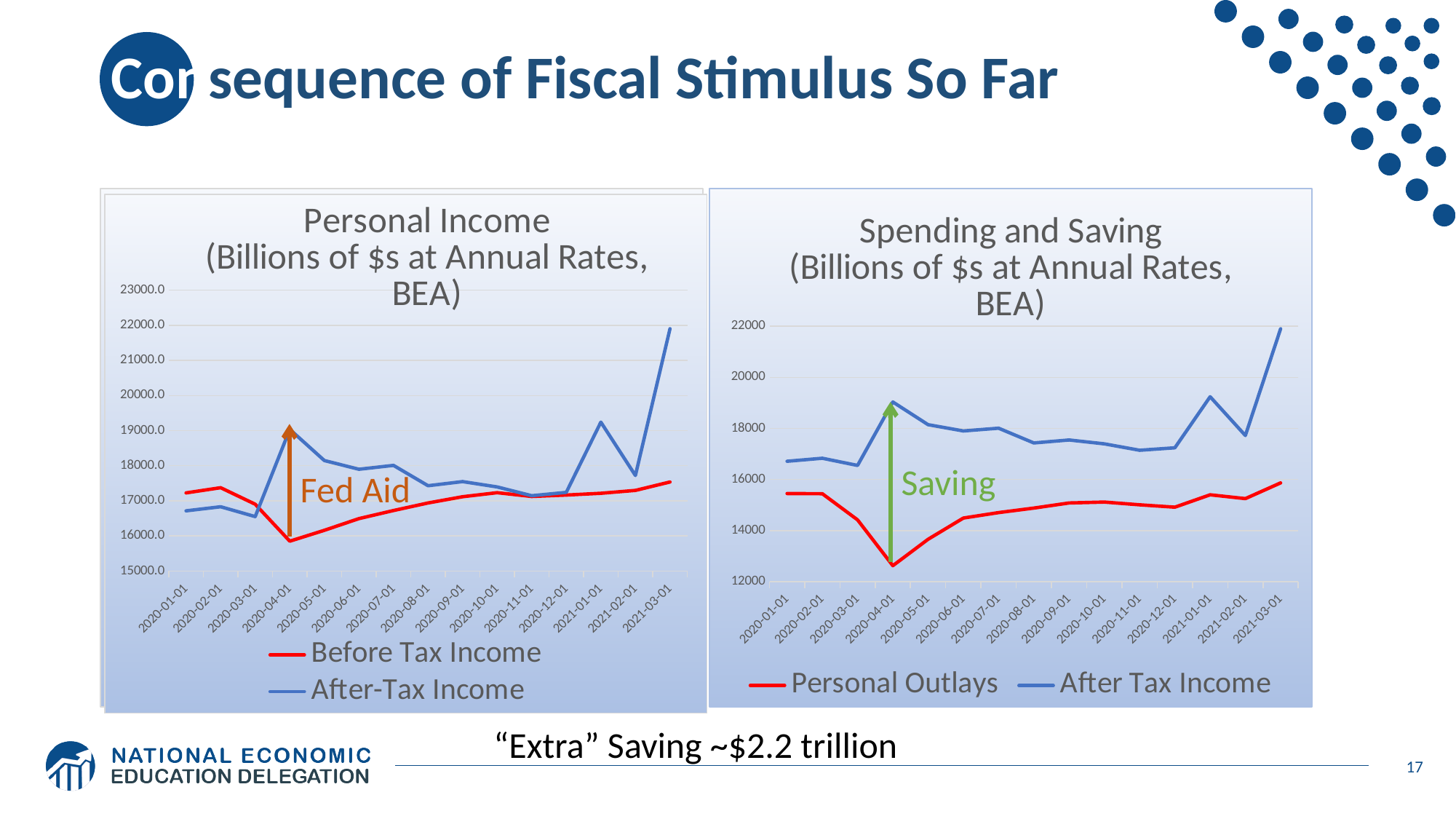
In the 'Personal Income' chart on the left, is the After-Tax Income value for 2020-01-01 greater or less than 17000.0? less In the 'Personal Income' chart on the left, is the After-Tax Income value for 2021-03-01 greater or less than 21000.0? greater What kind of chart is the 'Personal Income' chart on the left? line chart In the 'Personal Income' chart on the left, at which date is Before Tax Income lowest? 2020-04-01 In the 'Personal Income' chart on the left, which series has the larger value at 2020-04-01, Before Tax Income or After-Tax Income? After-Tax Income How many series does the legend of the 'Spending and Saving' chart on the right list? 2 In the 'Spending and Saving' chart on the right, is the Personal Outlays value for 2020-04-01 greater or less than 14000? less In the 'Spending and Saving' chart on the right, at which date is Personal Outlays lowest? 2020-04-01 In the 'Spending and Saving' chart on the right, which series is shown in red? Personal Outlays In the 'Personal Income' chart on the left, at which date does After-Tax Income reach its highest value? 2021-03-01 In the 'Personal Income' chart on the left, how many dates are shown on the x axis? 15